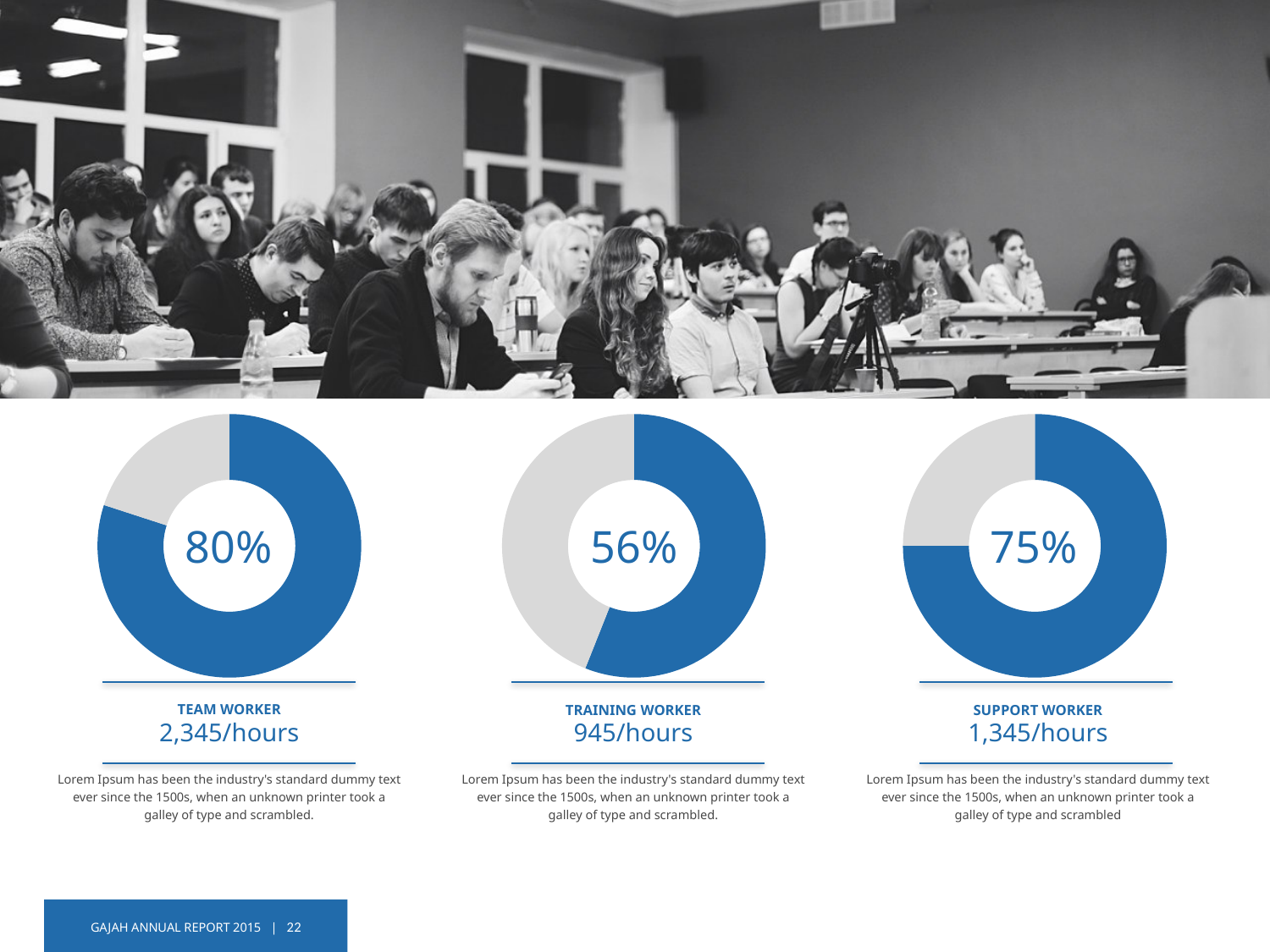
How many donut charts are shown on the slide? 3 Which is larger, the Support Worker percentage or the Training Worker percentage? Support Worker What hours figure is printed under the Training Worker donut chart? 945/hours What percentage is shown in the centre of the Team Worker donut chart? 80% What colour is the filled portion of the Support Worker donut chart? Blue What is the difference between the Team Worker percentage and the Training Worker percentage? 24% Which of the three donut charts shows the highest percentage? Team Worker What percentage is shown in the centre of the Training Worker donut chart? 56% What is the difference between the Support Worker percentage and the Training Worker percentage? 19% Which of the three donut charts shows the lowest percentage? Training Worker What percentage is shown in the centre of the Support Worker donut chart? 75% What kind of chart is used to show the Team Worker percentage? Donut chart